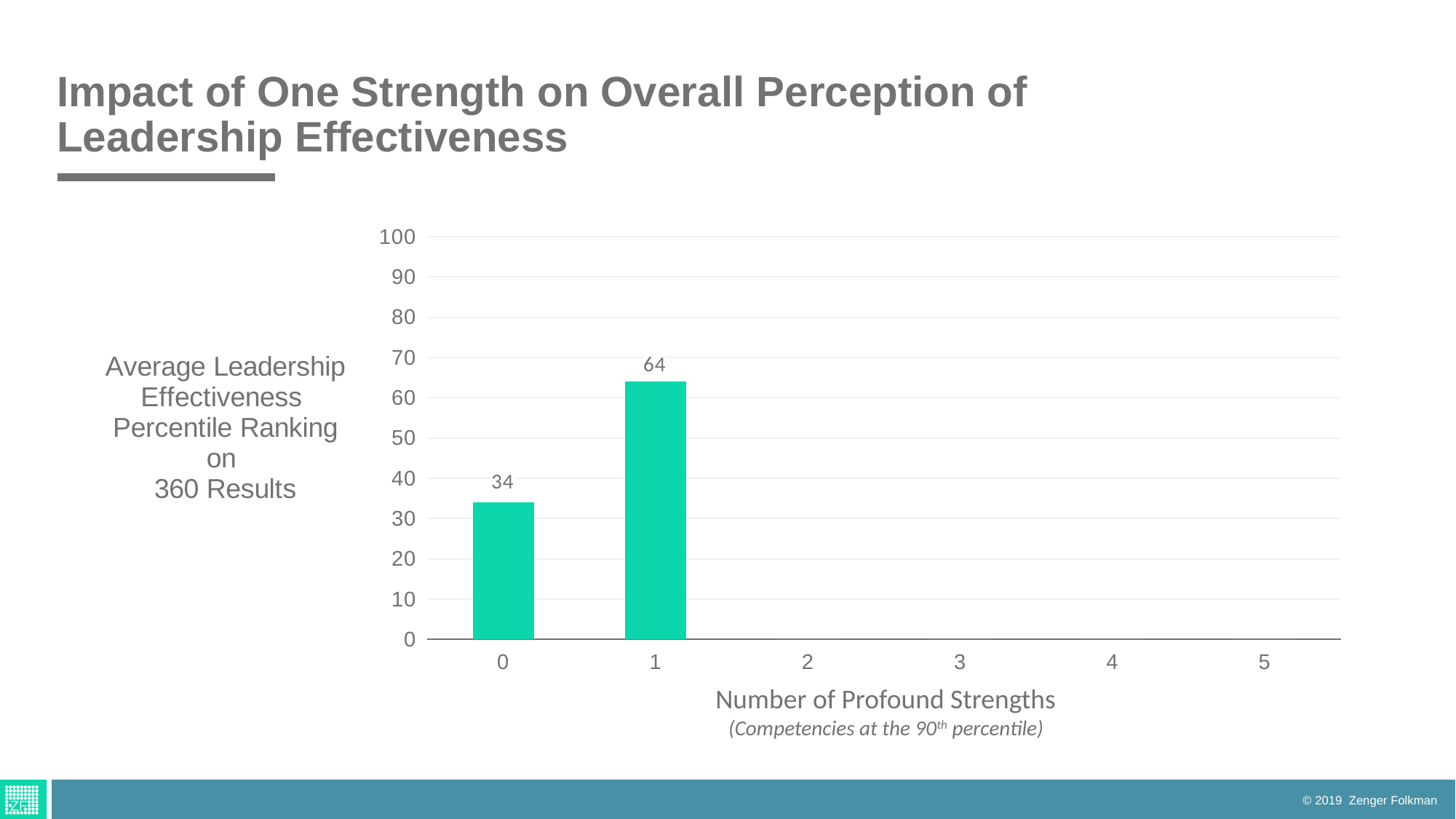
What kind of chart is shown on the slide? Bar chart What is the difference in percentile ranking between leaders with 1 profound strength and leaders with 0 profound strengths? 30 What is the average leadership effectiveness percentile ranking for leaders with 0 profound strengths? 34 Is the value for 0 profound strengths greater or less than 40? less What is the x-axis label of the chart? Number of Profound Strengths Which number of profound strengths has the higher plotted percentile ranking, 0 or 1? 1 Do the plotted values rise or fall from 0 to 1 profound strengths? Rise How many categories are labelled on the x axis of the chart? 6 Is the value for 1 profound strength greater or less than 60? greater What is the maximum value shown on the y axis of the chart? 100 What is the average leadership effectiveness percentile ranking for leaders with 1 profound strength? 64 How many bars are plotted with a visible value in the chart? 2